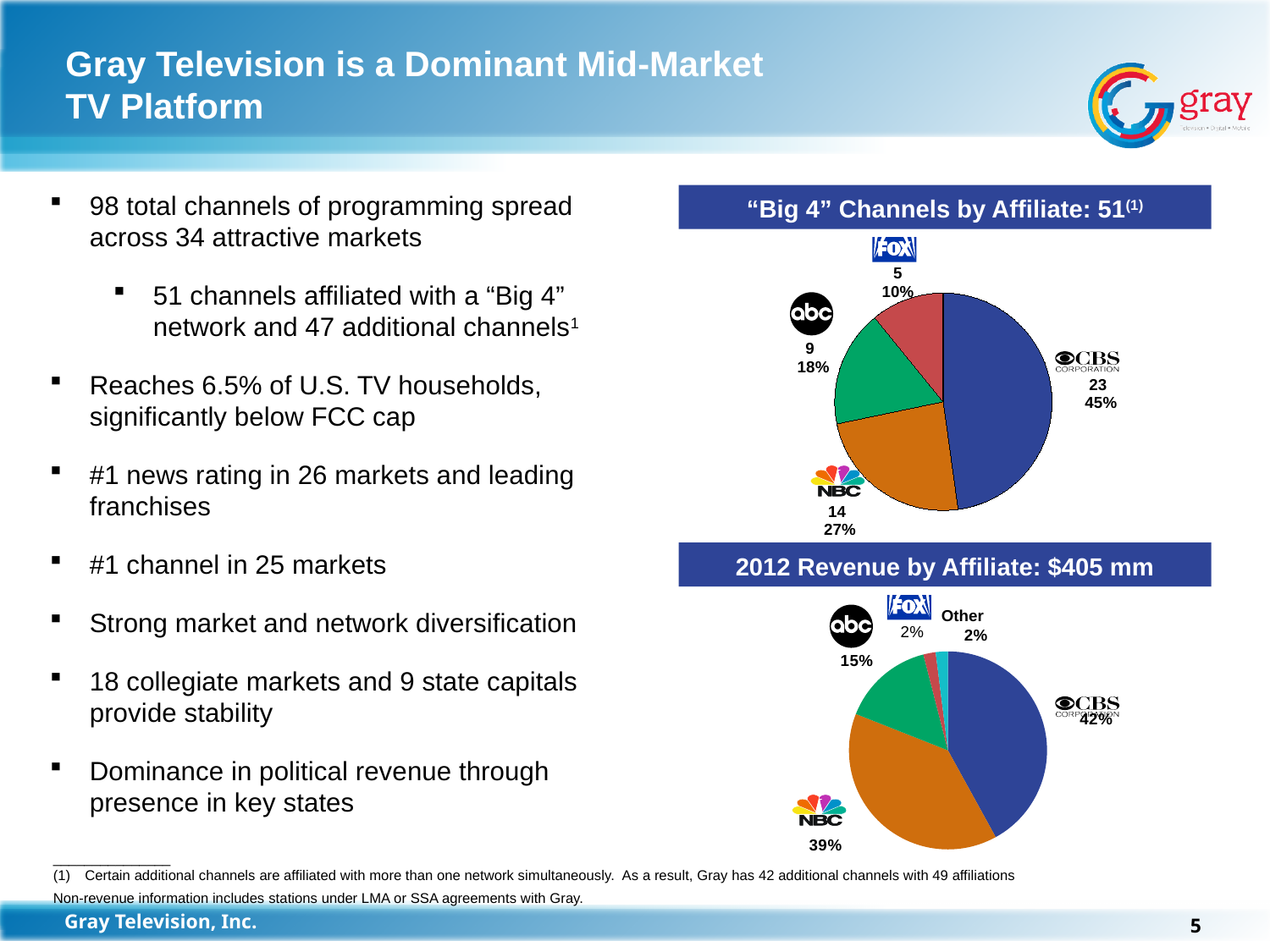
In the "Big 4" Channels by Affiliate chart, which affiliate has the most channels? CBS In the 2012 Revenue by Affiliate chart, what share of revenue comes from NBC? 39% What type of chart is the 2012 Revenue by Affiliate chart? Pie chart In the 2012 Revenue by Affiliate chart, which affiliate has the largest share of revenue? CBS What total revenue is stated in the title of the 2012 Revenue by Affiliate chart? $405 mm In the "Big 4" Channels by Affiliate chart, how many more channels are affiliated with CBS than with NBC? 9 In the "Big 4" Channels by Affiliate chart, which affiliate has the fewest channels? FOX In the "Big 4" Channels by Affiliate chart, how many slices does the pie have? 4 In the "Big 4" Channels by Affiliate chart, what share of channels is affiliated with NBC? 27% In the 2012 Revenue by Affiliate chart, what share of revenue comes from ABC? 15% In the 2012 Revenue by Affiliate chart, how many slices does the pie have? 5 In the "Big 4" Channels by Affiliate chart, how many channels are affiliated with CBS? 23